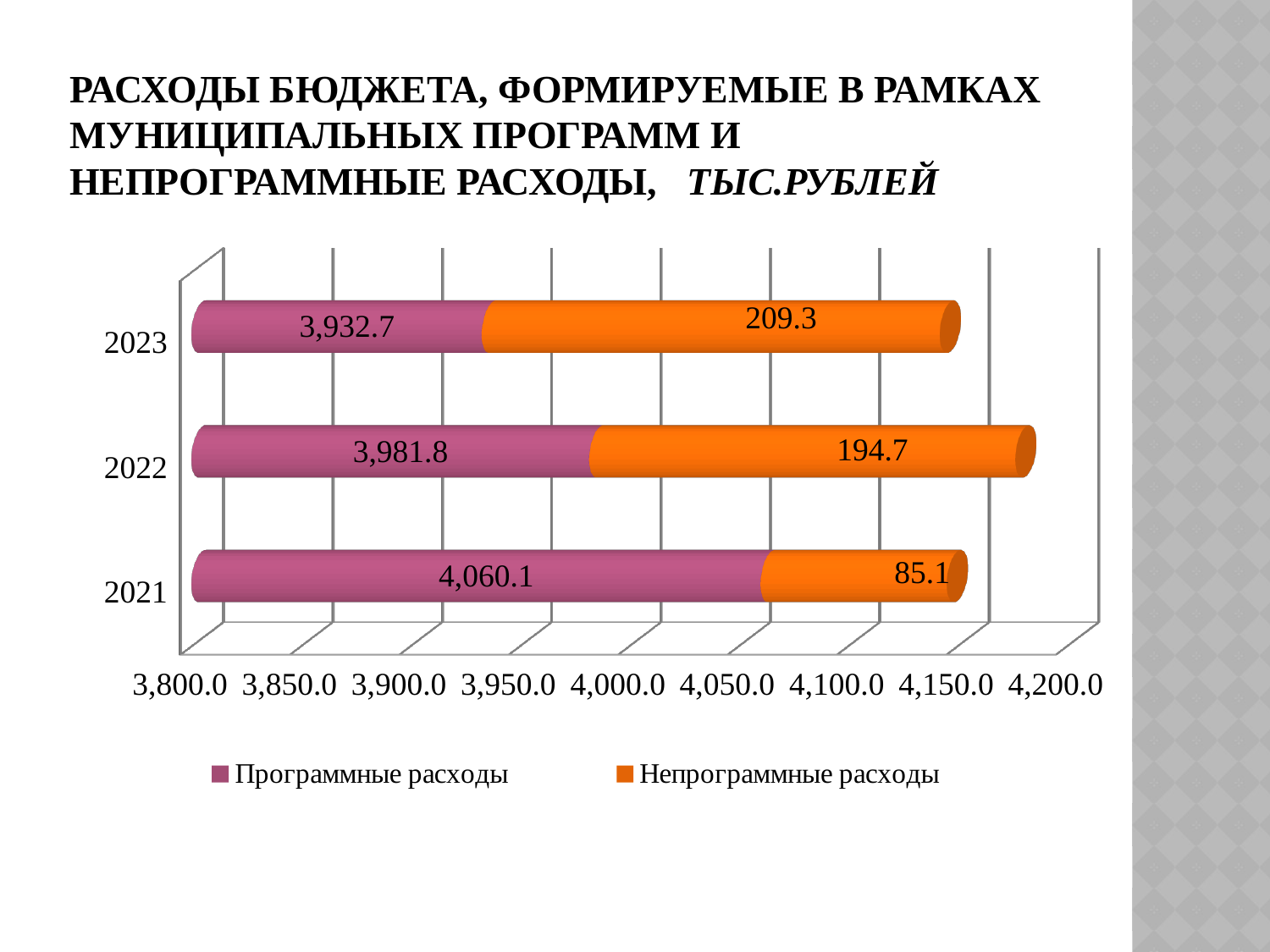
Do the values for Программные расходы rise or fall from 2021 to 2023? Fall What is the difference between Программные расходы in 2021 and in 2023? 127.4 How many years are shown on the chart? 3 What is the total of the stacked bar for 2022? 4,176.5 How many series does the legend list? 2 What kind of chart is shown on the slide? Stacked bar chart Which year has the lowest value for Непрограммные расходы? 2021 What is the value of Программные расходы for 2023? 3,932.7 Which year has the highest value for Программные расходы? 2021 What is the value of Непрограммные расходы for 2022? 194.7 Which is larger: Непрограммные расходы in 2022 or in 2023? 2023 What is the value of Непрограммные расходы for 2021? 85.1